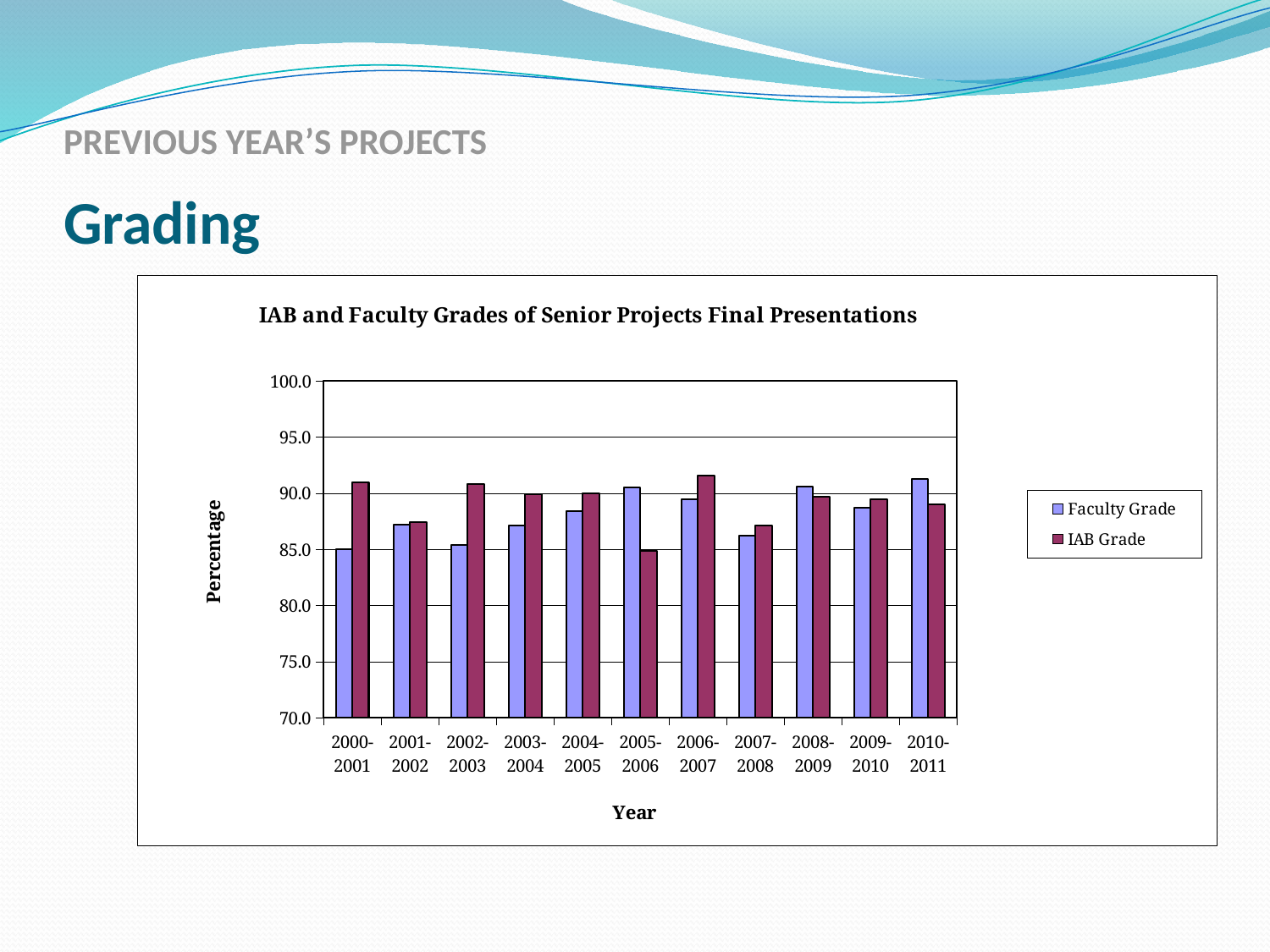
What kind of chart is shown on the slide? Bar chart What is the label of the vertical axis? Percentage How many academic years are shown on the x axis? 11 Which year has the highest Faculty Grade? 2010-2011 How many series does the legend list? 2 Is the Faculty Grade for 2000-2001 greater or less than 90.0? less In 2005-2006, which is larger, the Faculty Grade or the IAB Grade? Faculty Grade What is the title of the chart? IAB and Faculty Grades of Senior Projects Final Presentations In 2000-2001, which is larger, the Faculty Grade or the IAB Grade? IAB Grade Is the IAB Grade for 2005-2006 greater or less than 90.0? less Is the IAB Grade for 2006-2007 greater or less than 90.0? greater Which year has the lowest IAB Grade? 2005-2006